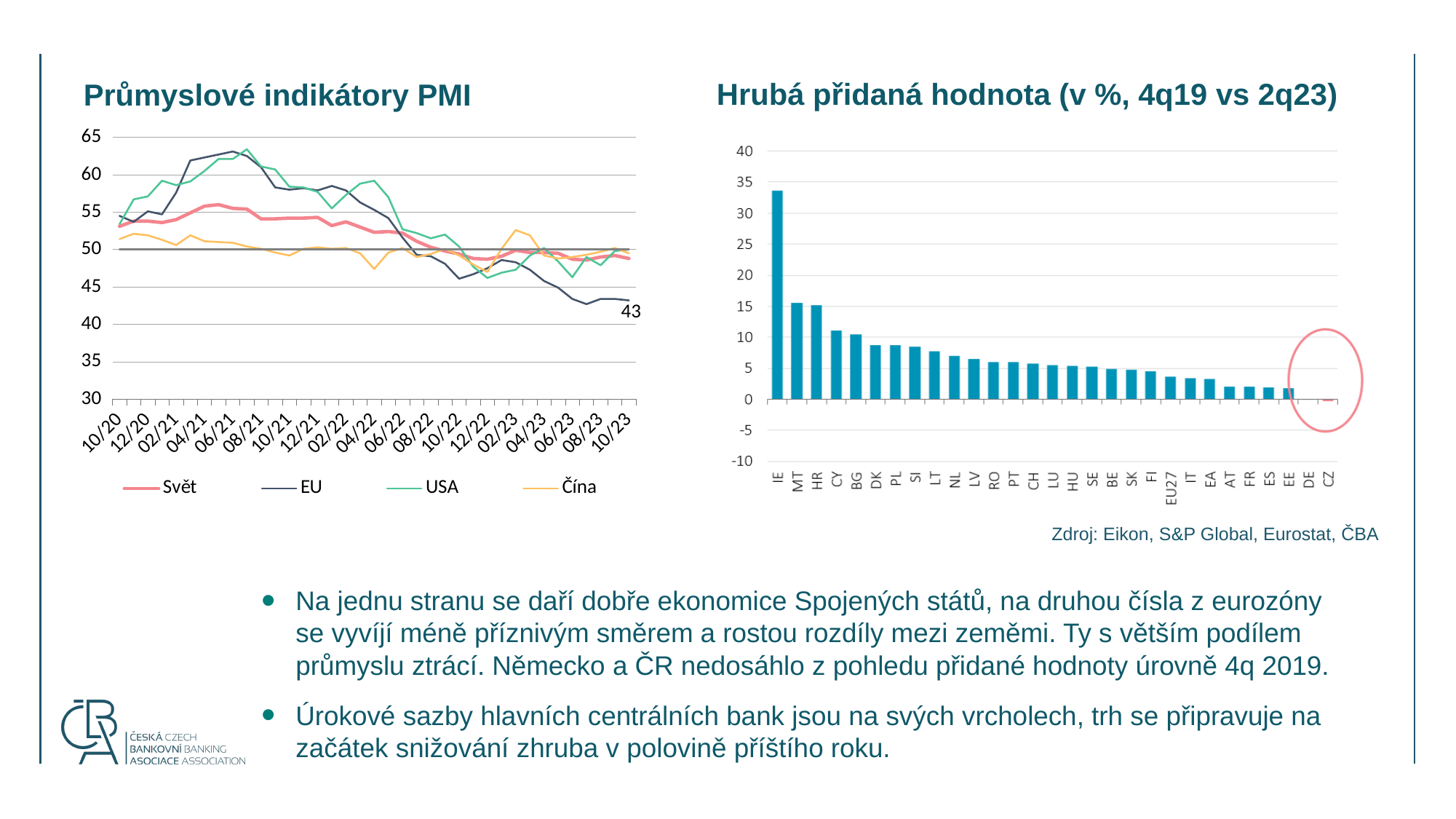
What kind of chart is the 'Hrubá přidaná hodnota (v %, 4q19 vs 2q23)' chart on the right? bar chart How many countries/regions are shown on the x axis of the 'Hrubá přidaná hodnota' chart? 29 In the 'Průmyslové indikátory PMI' chart, does the EU line end higher or lower at 10/23 than it started at 10/20? lower In the 'Hrubá přidaná hodnota' chart, which country has the highest value? IE In the 'Hrubá přidaná hodnota' chart, which country has the lowest value? CZ How many series does the legend of the 'Průmyslové indikátory PMI' chart list? 4 What kind of chart is the 'Průmyslové indikátory PMI' chart on the left? line chart In the 'Hrubá přidaná hodnota' chart, is the value for EU27 greater or less than 5? less In the 'Průmyslové indikátory PMI' chart, what value is labelled at the end of the EU line at 10/23? 43 In the 'Hrubá přidaná hodnota' chart, is the value for MT greater or less than 20? less In the 'Hrubá přidaná hodnota' chart, is the value for IE greater or less than 30? greater In the 'Hrubá přidaná hodnota' chart, which is larger, the value for HR or the value for CY? HR